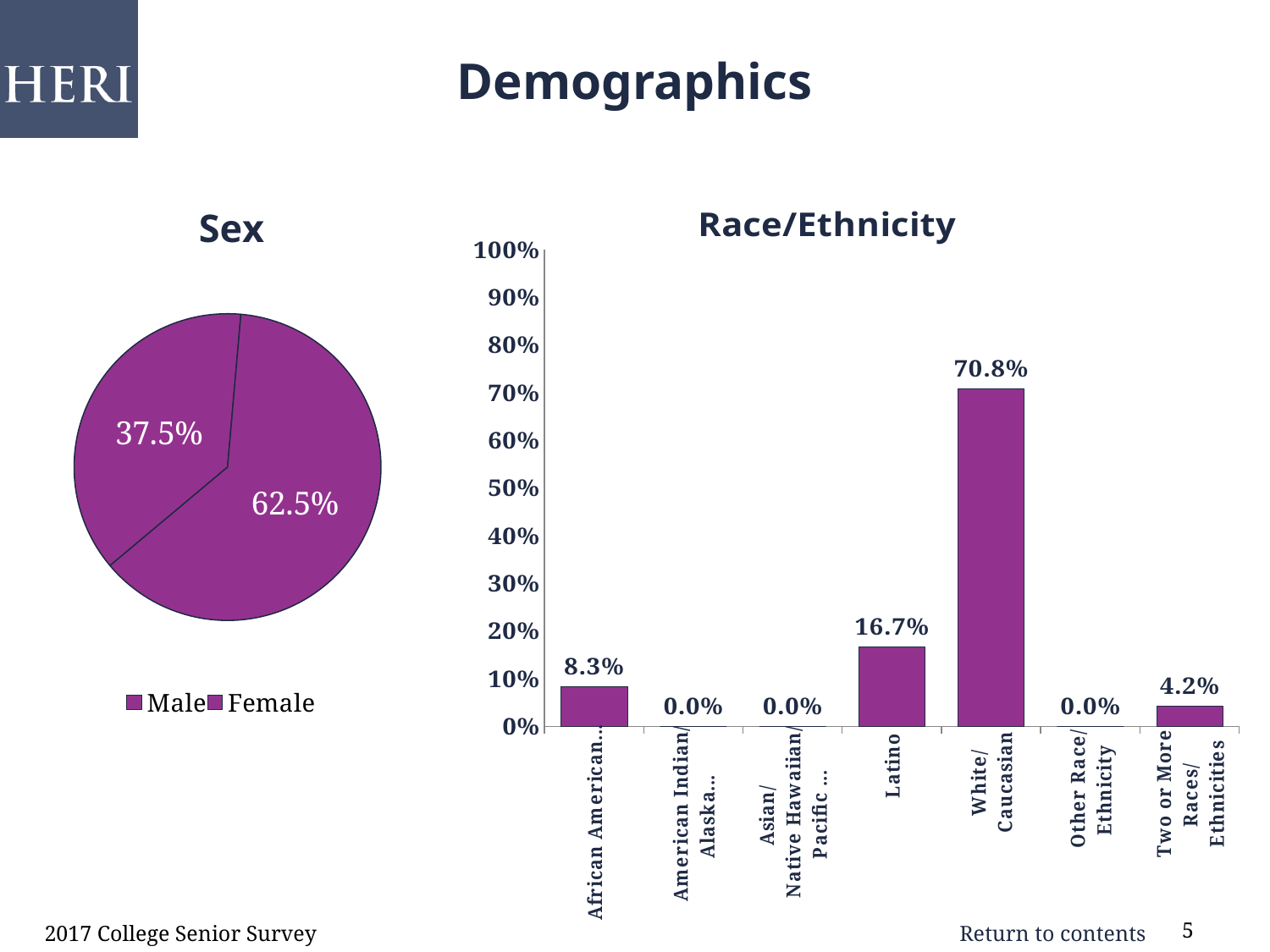
In the Race/Ethnicity chart, which category has the highest value? White/Caucasian In the Sex pie chart, what is the value of the larger slice? 62.5% In the Race/Ethnicity chart, what is the value for Other Race/Ethnicity? 0.0% In the Race/Ethnicity chart, which is larger, the value for Latino or the value for Two or More Races/Ethnicities? Latino In the Race/Ethnicity chart, how many categories are shown on the x axis? 7 What kind of chart is the Sex chart? Pie chart In the Race/Ethnicity chart, what is the value for Latino? 16.7% In the Race/Ethnicity chart, what is the value for White/Caucasian? 70.8% How many entries does the legend of the Sex chart list? 2 In the Race/Ethnicity chart, what is the value for Two or More Races/Ethnicities? 4.2% In the Race/Ethnicity chart, what is the difference between the White/Caucasian and Latino values? 54.1% In the Race/Ethnicity chart, how many categories have a value of 0.0%? 3